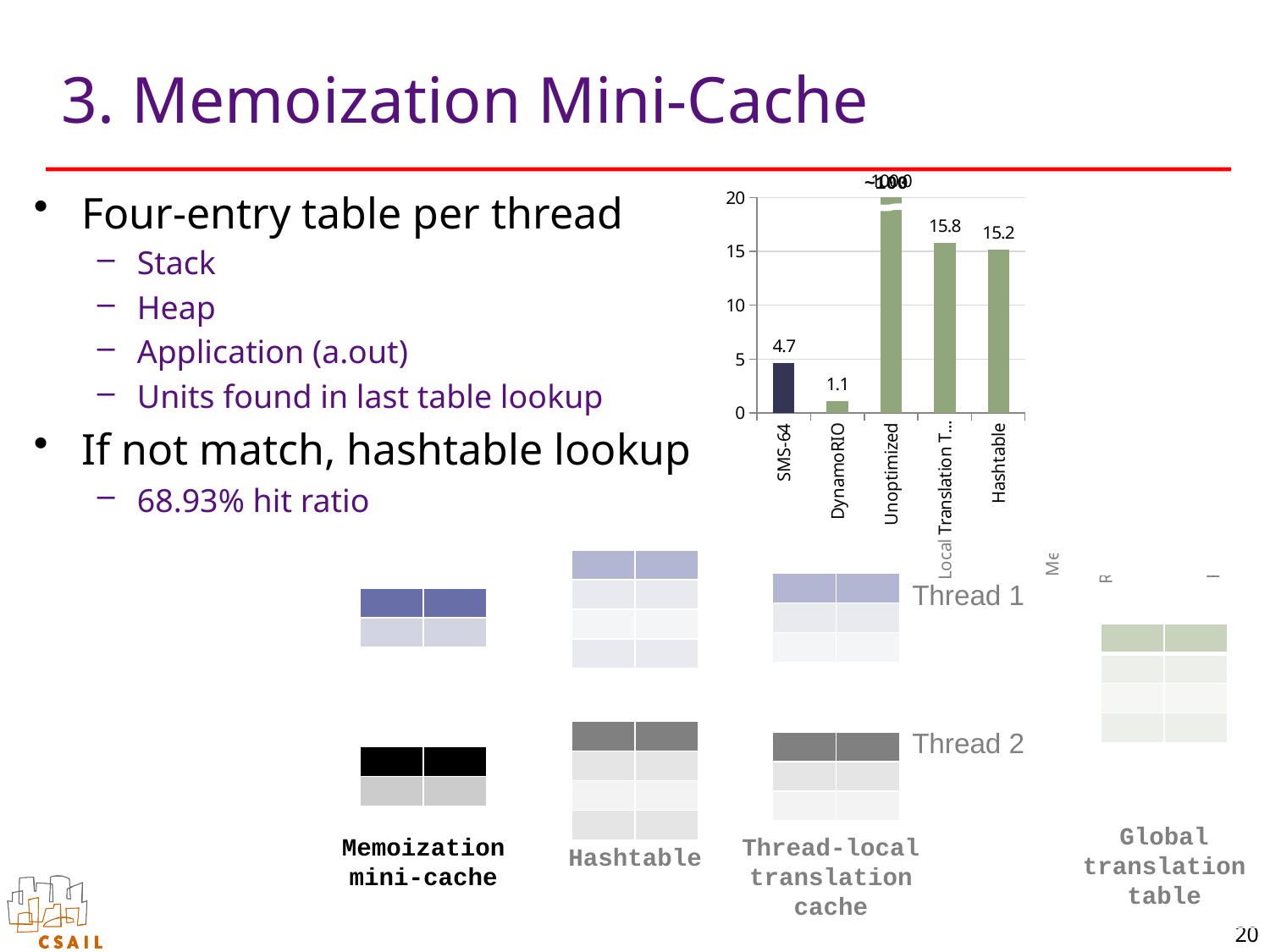
Is the value for Hashtable greater or less than 10? greater What is the value for SMS-64 in the bar chart? 4.7 Which category has the lowest value in the bar chart? DynamoRIO Which category has the highest value in the bar chart? Unoptimized What is the value for DynamoRIO in the bar chart? 1.1 What kind of chart is shown on the slide? bar chart What is the value for the category whose label begins 'Local Translation' in the bar chart? 15.8 What is the difference between the values for SMS-64 and DynamoRIO? 3.6 What is the value for Hashtable in the bar chart? 15.2 Which is larger, the value for SMS-64 or the value for Hashtable? Hashtable What is the difference between the value for the 'Local Translation' category and the value for Hashtable? 0.6